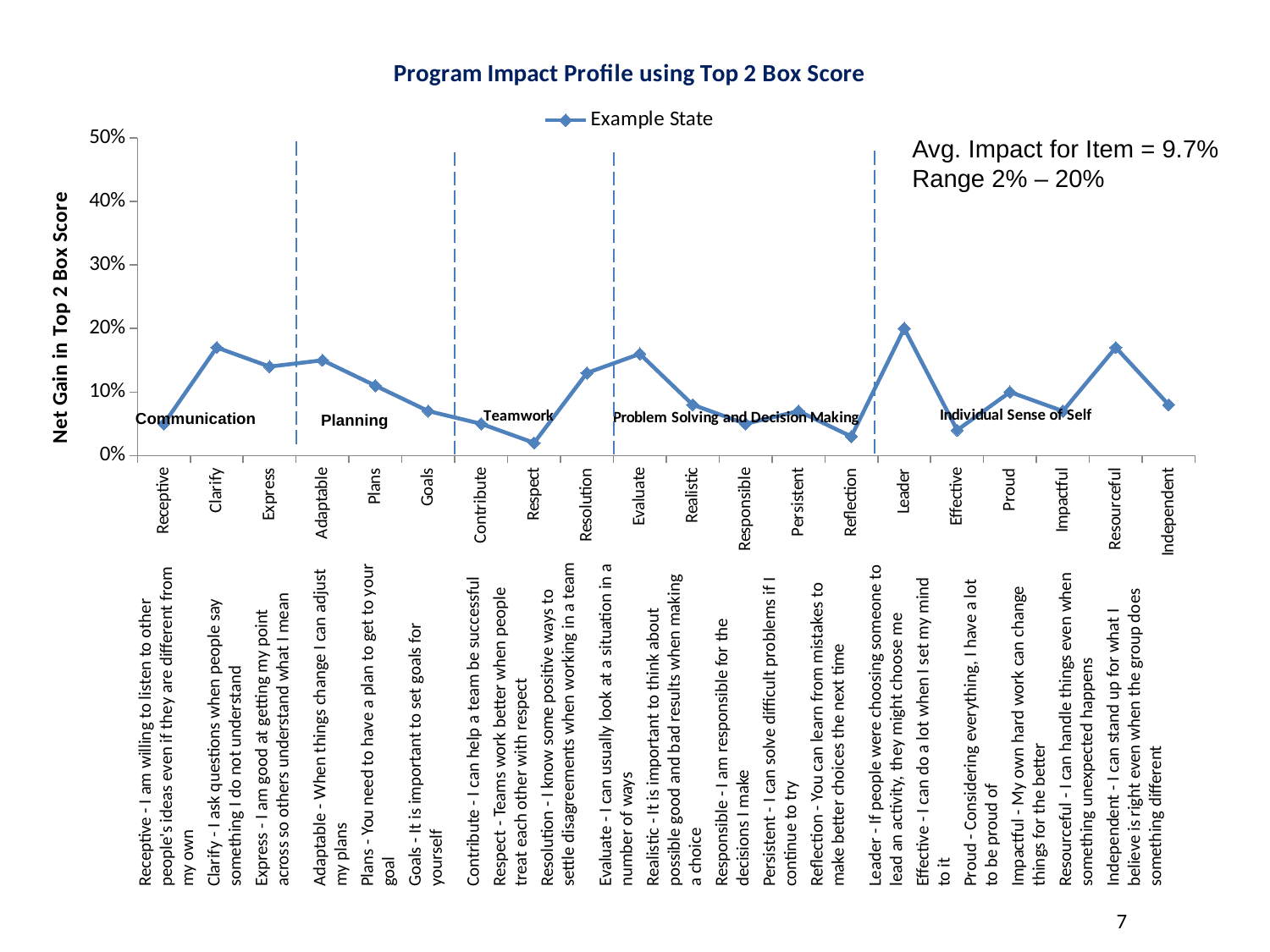
Which is larger, the value for Evaluate or the value for Realistic? Evaluate Is the value for Resourceful greater or less than 10%? greater How many categories are plotted along the x axis? 20 What kind of chart is shown on the slide? line chart Is the value for Clarify greater or less than 10%? greater Is the value for Reflection greater or less than 10%? less What is the name of the series shown in the legend? Example State Do the values rise or fall from Adaptable to Goals? fall How many series does the legend list? 1 Which category has the lowest net gain in Top 2 Box Score? Respect Which category has the highest net gain in Top 2 Box Score? Leader What is the value for Leader? 20%